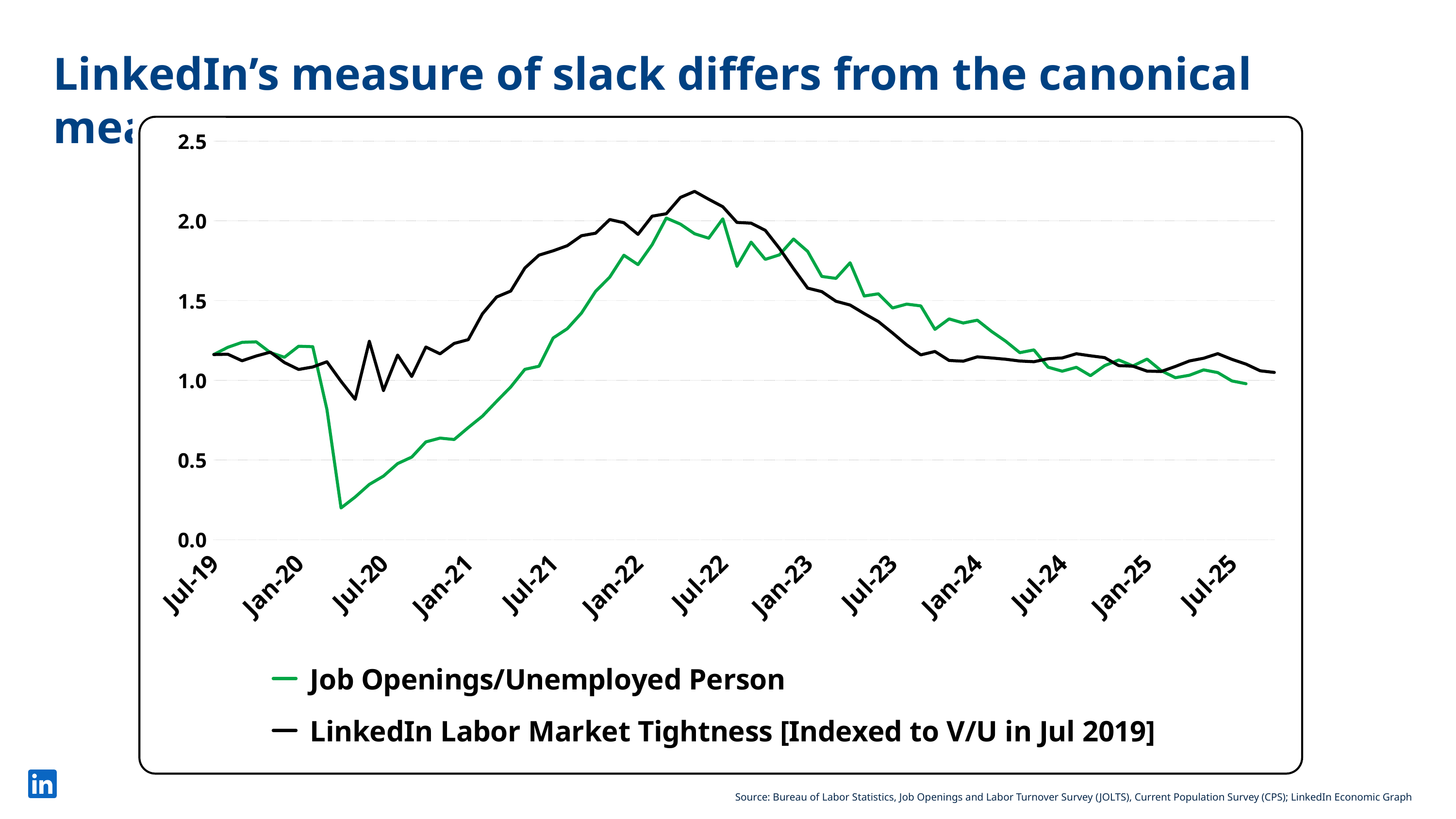
Between Jul-22 and Jan-24, do the values of the Job Openings/Unemployed Person line rise or fall? Fall Which series reaches the higher peak value? LinkedIn Labor Market Tightness What colour is the line for LinkedIn Labor Market Tightness? Black What kind of chart is shown on the slide? Line chart At Jul-21, which series has the higher value? LinkedIn Labor Market Tightness How many date labels are shown on the x axis? 13 How many series does the legend list? 2 Is the peak value of the LinkedIn Labor Market Tightness line greater or less than 2.0? greater Is the value of Job Openings/Unemployed Person at Jan-21 greater or less than 1.0? less Is the lowest value of the Job Openings/Unemployed Person line greater or less than 0.5? less Which series falls to the lower minimum value? Job Openings/Unemployed Person What is the label of the green series in the legend? Job Openings/Unemployed Person